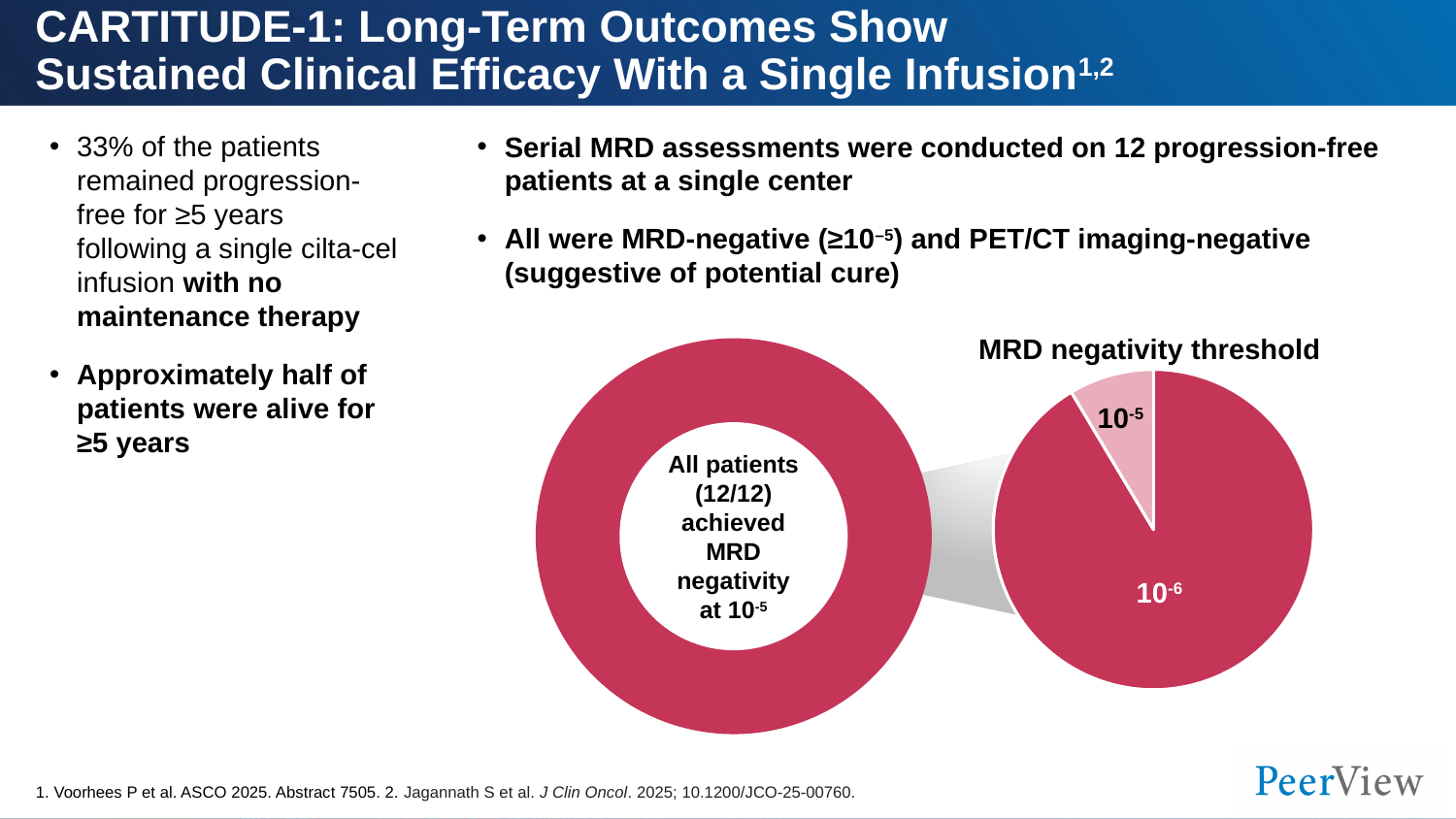
What kind of chart is the chart on the right titled 'MRD negativity threshold'? pie chart In the 'MRD negativity threshold' pie chart, is the 10-6 slice more or less than half of the pie? more In the 'MRD negativity threshold' pie chart, what colour is the 10-5 slice? light pink In the 'MRD negativity threshold' pie chart, which slice is larger, 10-5 or 10-6? 10-6 In the 'MRD negativity threshold' pie chart, which slice is the largest? 10-6 What kind of chart is the large chart in the centre with the text 'All patients (12/12) achieved MRD negativity at 10-5'? donut chart In the 'MRD negativity threshold' pie chart, which slice is the smallest? 10-5 According to the text inside the central donut chart, how many patients achieved MRD negativity at 10-5? 12/12 In the 'MRD negativity threshold' pie chart, how many slices are shown? 2 What is the title of the pie chart on the right of the slide? MRD negativity threshold